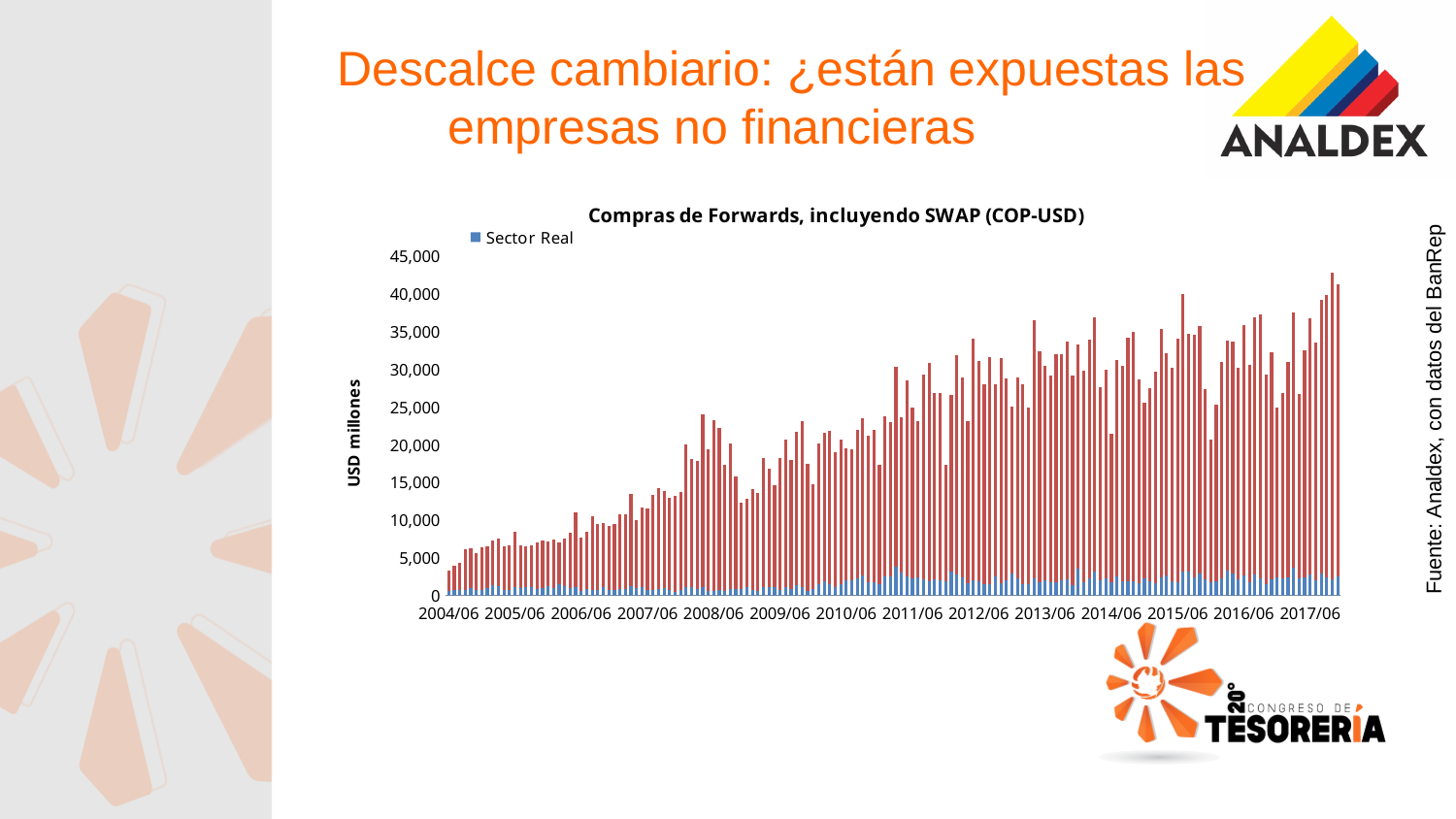
What kind of chart is shown on the slide? bar chart How many series does the chart's legend list? 1 Are the Sector Real (blue) bars greater or less than 5,000 throughout the chart? less What is the label of the vertical axis of the chart? USD millones What is the title of the chart? Compras de Forwards, incluyendo SWAP (COP-USD) How many year labels are shown along the x axis of the chart? 14 Is the red bar at 2017/06 greater or less than 25,000? greater Which has the larger red bar, 2008/06 or 2012/06? 2012/06 Is the red bar at 2008/06 greater or less than 10,000? greater Which has the larger red bar, 2004/06 or 2017/06? 2017/06 Do the red bars generally rise or fall from 2004/06 to 2017/06? rise